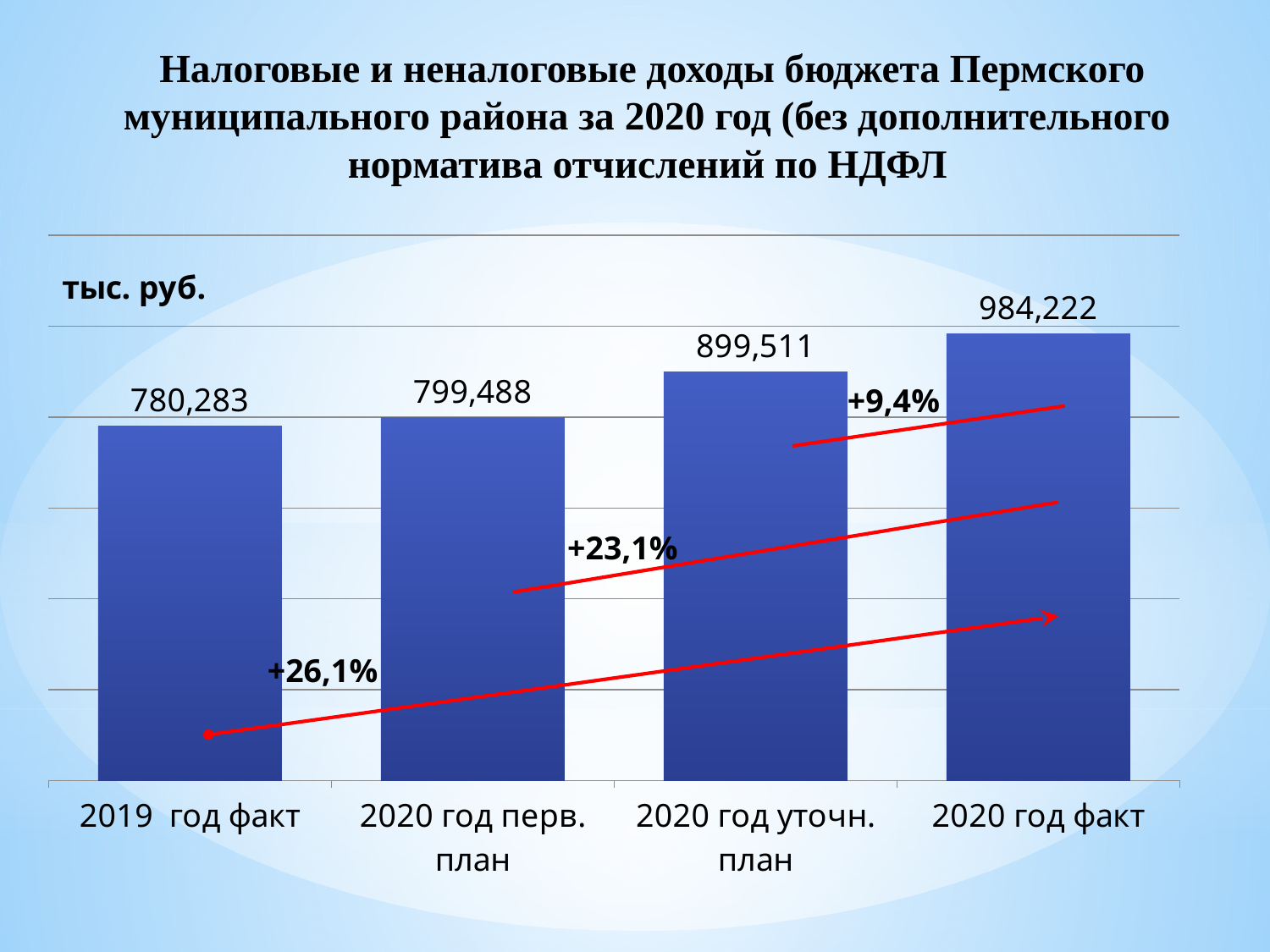
How many bars are shown in the chart? 4 What kind of chart is shown on the slide? bar chart What is the difference between the values for 2020 год уточн. план and 2020 год перв. план? 100,023 Which category has the highest value? 2020 год факт Do the values rise or fall from left to right along the x axis? rise What is the value for 2020 год факт? 984,222 What is the difference between the values for 2020 год факт and 2019 год факт? 203,939 What is the value for 2020 год уточн. план? 899,511 What is the value for 2020 год перв. план? 799,488 Which is larger, the value for 2020 год уточн. план or the value for 2020 год перв. план? 2020 год уточн. план Which category has the lowest value? 2019 год факт What is the value for 2019 год факт? 780,283